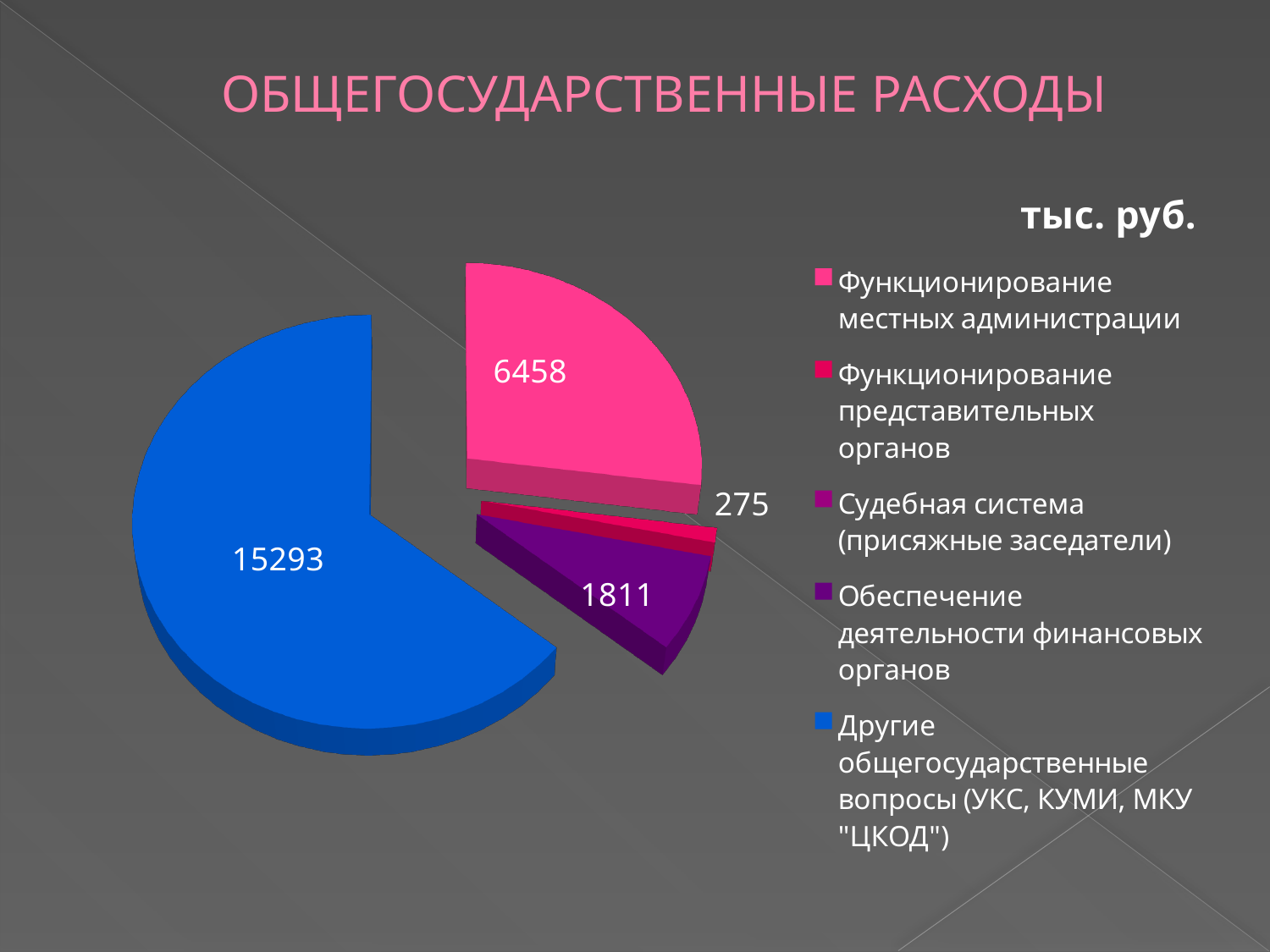
What is the value for "Функционирование представительных органов"? 275 What kind of chart is shown on the slide? Pie chart Which category has the largest slice of the pie? Другие общегосударственные вопросы (УКС, КУМИ, МКУ "ЦКОД") What is the value for "Функционирование местных администрации"? 6458 What colour is the slice for "Другие общегосударственные вопросы"? Blue What is the difference between the value for "Другие общегосударственные вопросы" and the value for "Функционирование местных администрации"? 8835 How many categories does the legend of the pie chart list? 5 What is the value for "Другие общегосударственные вопросы (УКС, КУМИ, МКУ "ЦКОД")"? 15293 What is the title of the chart on the slide? ОБЩЕГОСУДАРСТВЕННЫЕ РАСХОДЫ Which is larger: "Функционирование местных администрации" or "Функционирование представительных органов"? Функционирование местных администрации In what units are the values on the chart given? тыс. руб. What is the difference between the value for "Функционирование местных администрации" and the value for "Функционирование представительных органов"? 6183